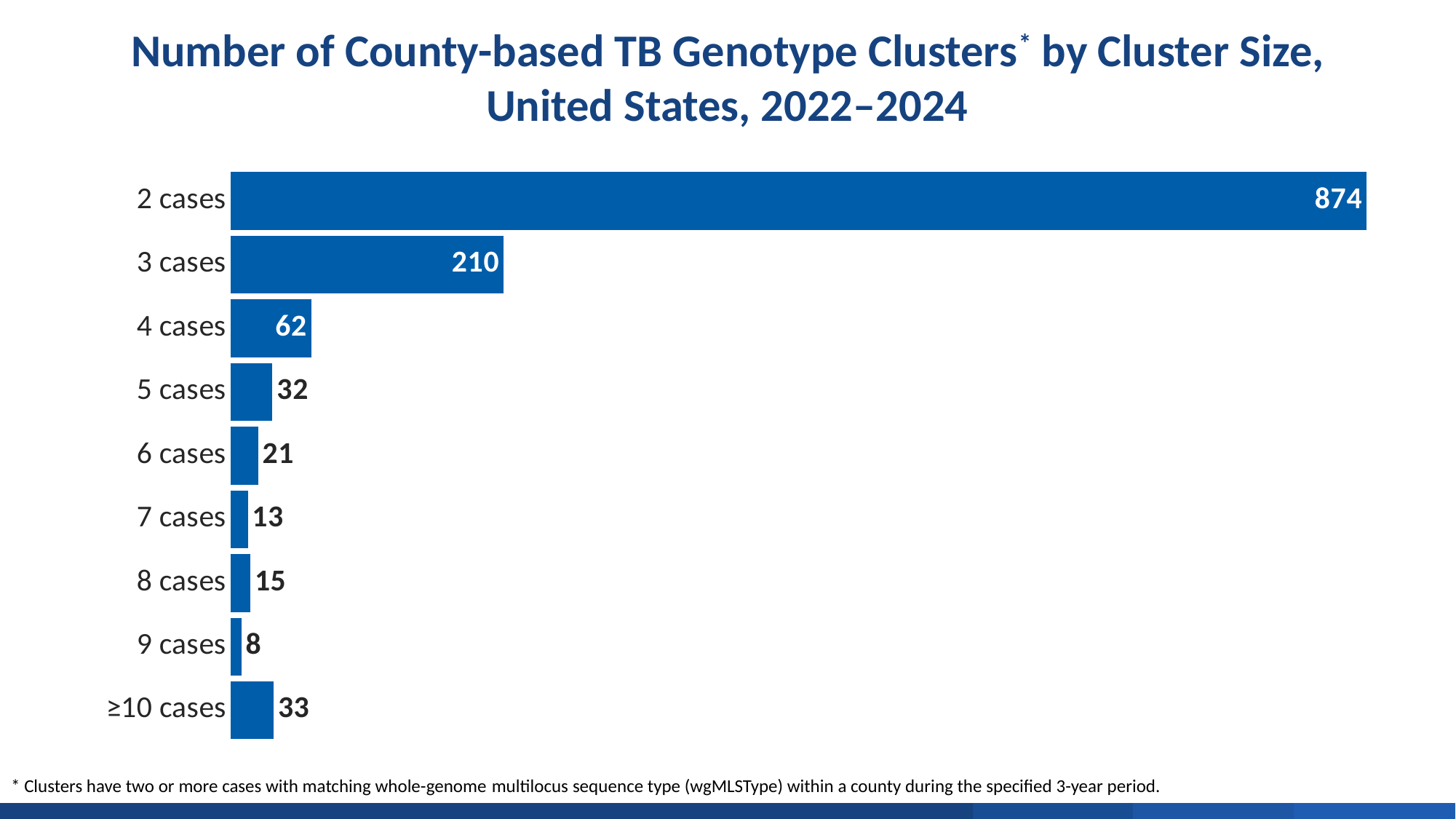
How many clusters had ≥10 cases? 33 What is the value shown for clusters with 7 cases? 13 How many county-based TB genotype clusters had 2 cases? 874 How many cluster size categories are shown in the chart? 9 What is the number of clusters with 3 cases? 210 What is the difference between the number of clusters with 4 cases and with 5 cases? 30 What is the difference between the number of clusters with 2 cases and the number with 3 cases? 664 Which cluster size has the highest number of clusters? 2 cases Which cluster size has the lowest number of clusters? 9 cases Which has more clusters: 8 cases or 7 cases? 8 cases What type of chart is shown on the slide? Bar chart Which has more clusters: ≥10 cases or 5 cases? ≥10 cases